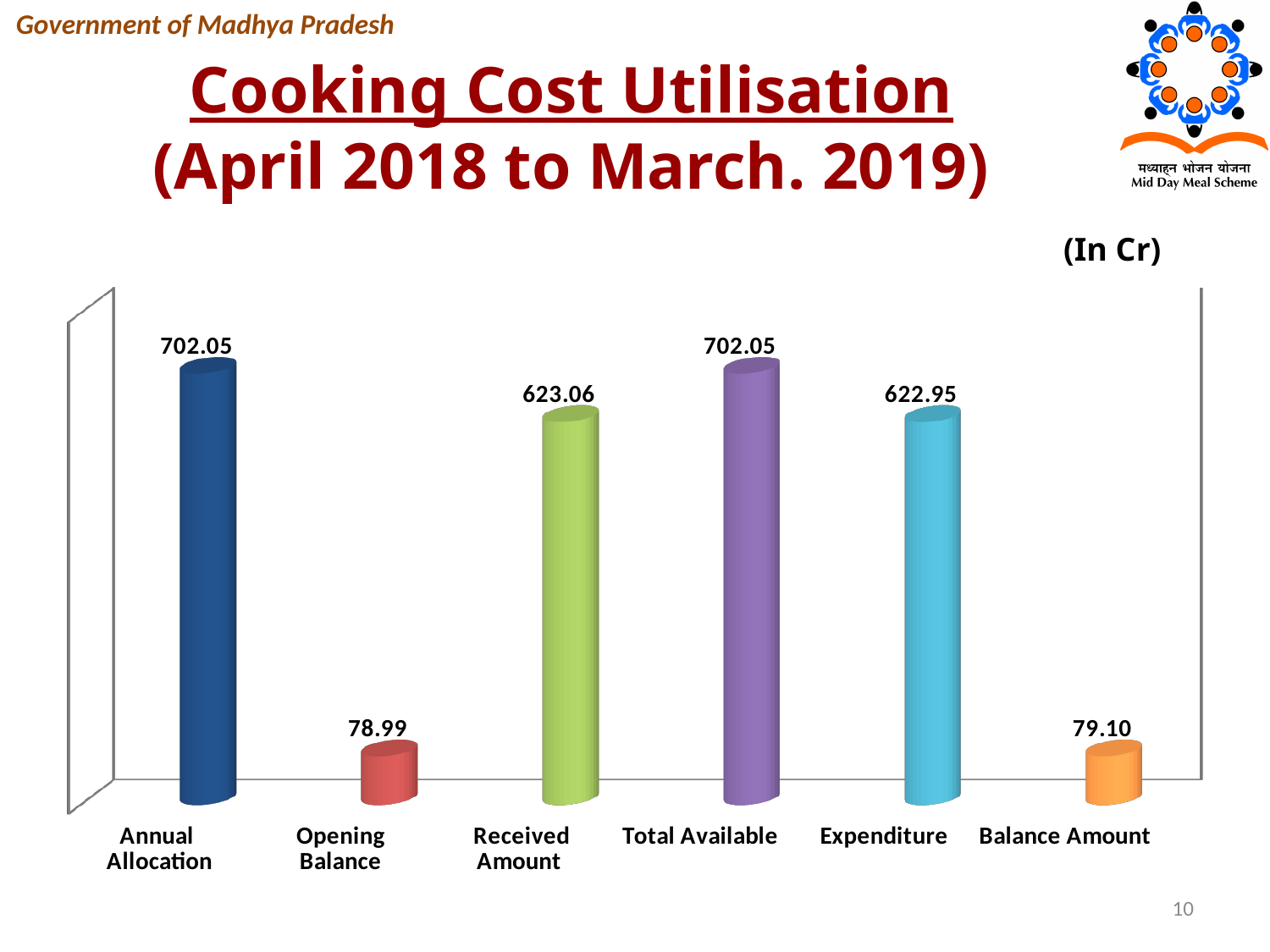
In what unit are the chart values expressed, according to the slide? In Cr Which is larger, Annual Allocation or Received Amount? Annual Allocation What is the difference between Total Available and Expenditure? 79.10 What is the value for Expenditure? 622.95 How many categories are shown on the chart? 6 What is the value for Annual Allocation? 702.05 What kind of chart is shown on the slide? Bar chart What is the difference between Annual Allocation and Received Amount? 78.99 What is the value for Balance Amount? 79.10 Which is larger, Opening Balance or Expenditure? Expenditure What is the value for Received Amount? 623.06 What is the value for Opening Balance? 78.99